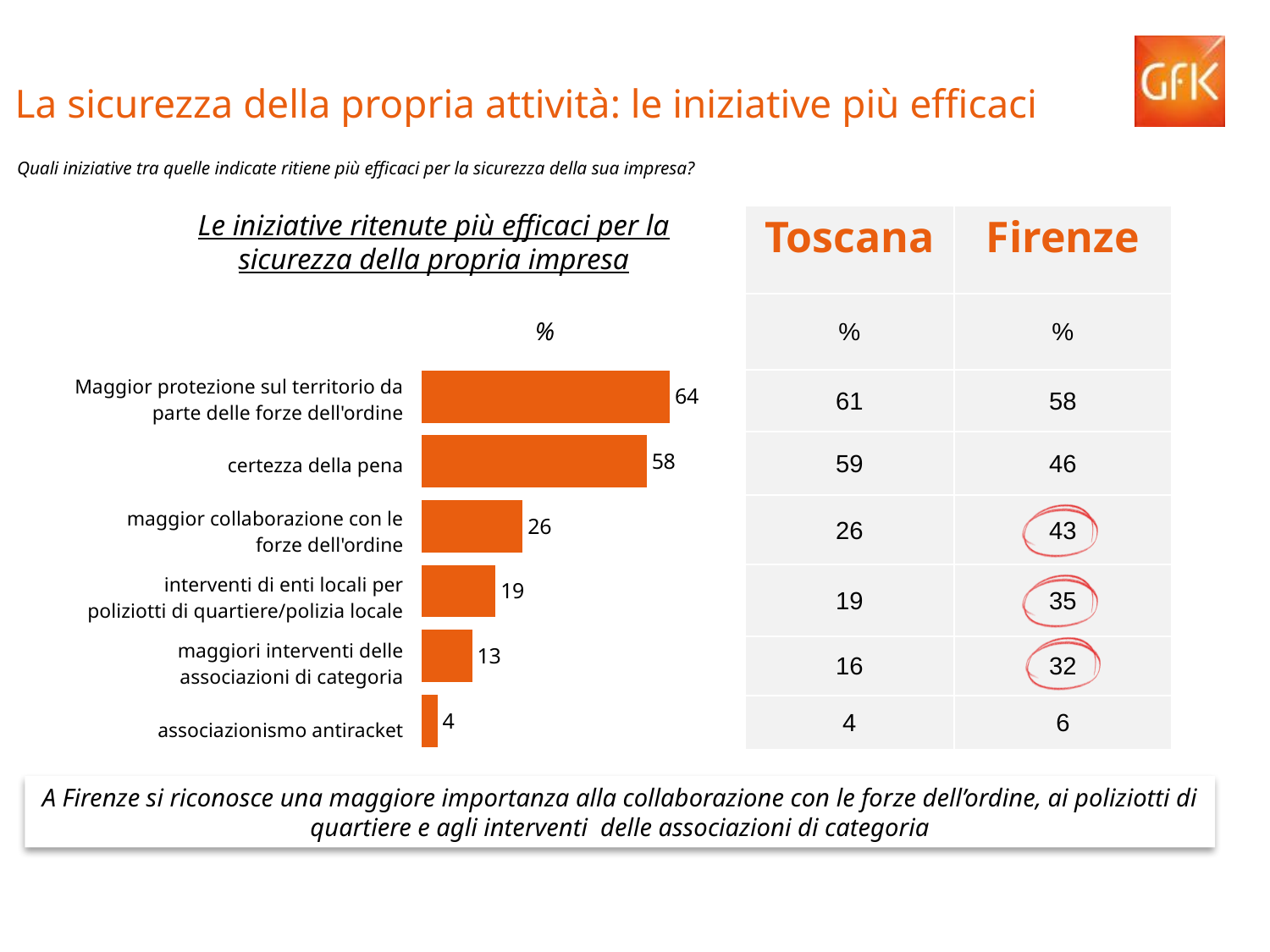
Which category has the highest value in the bar chart? Maggior protezione sul territorio da parte delle forze dell'ordine Which is larger in the bar chart: the value for "interventi di enti locali per poliziotti di quartiere/polizia locale" or for "maggiori interventi delle associazioni di categoria"? interventi di enti locali per poliziotti di quartiere/polizia locale How many categories are shown in the bar chart? 6 What kind of chart is shown on the slide? bar chart What is the difference between the values for "Maggior protezione sul territorio da parte delle forze dell'ordine" and "certezza della pena"? 6 Which category has the lowest value in the bar chart? associazionismo antiracket What is the difference between the values for "maggior collaborazione con le forze dell'ordine" and "interventi di enti locali per poliziotti di quartiere/polizia locale"? 7 What is the title of the bar chart? Le iniziative ritenute più efficaci per la sicurezza della propria impresa What is the value for "maggiori interventi delle associazioni di categoria" in the bar chart? 13 What is the value for "associazionismo antiracket" in the bar chart? 4 What is the value for "maggior collaborazione con le forze dell'ordine" in the bar chart? 26 What is the value for "certezza della pena" in the bar chart? 58